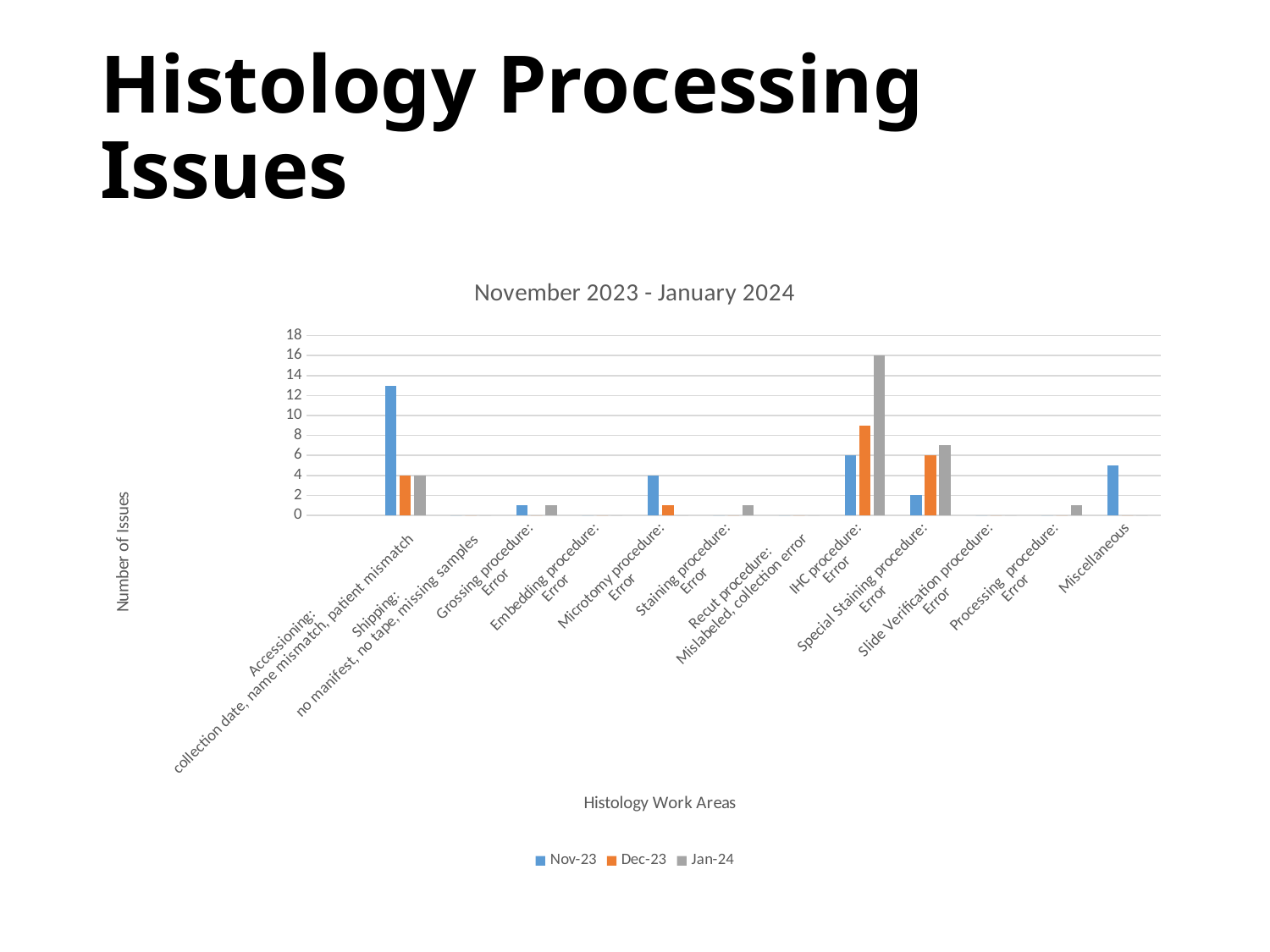
What is the Dec-23 value for Special Staining procedure: Error? 6 Is the Nov-23 value for Accessioning greater or less than 12? greater What is the Nov-23 value for Microtomy procedure: Error? 4 Which category has the highest Jan-24 value? IHC procedure: Error Which is larger for Special Staining procedure: Error, the Nov-23 value or the Dec-23 value? Dec-23 What is the Nov-23 value for IHC procedure: Error? 6 How many categories are shown on the x axis? 12 What is the Jan-24 value for IHC procedure: Error? 16 What type of chart is shown on the slide? bar chart How many series does the legend list? 3 Is the Dec-23 value for IHC procedure: Error greater or less than 8? greater Which category has the highest Nov-23 value? Accessioning: collection date, name mismatch, patient mismatch